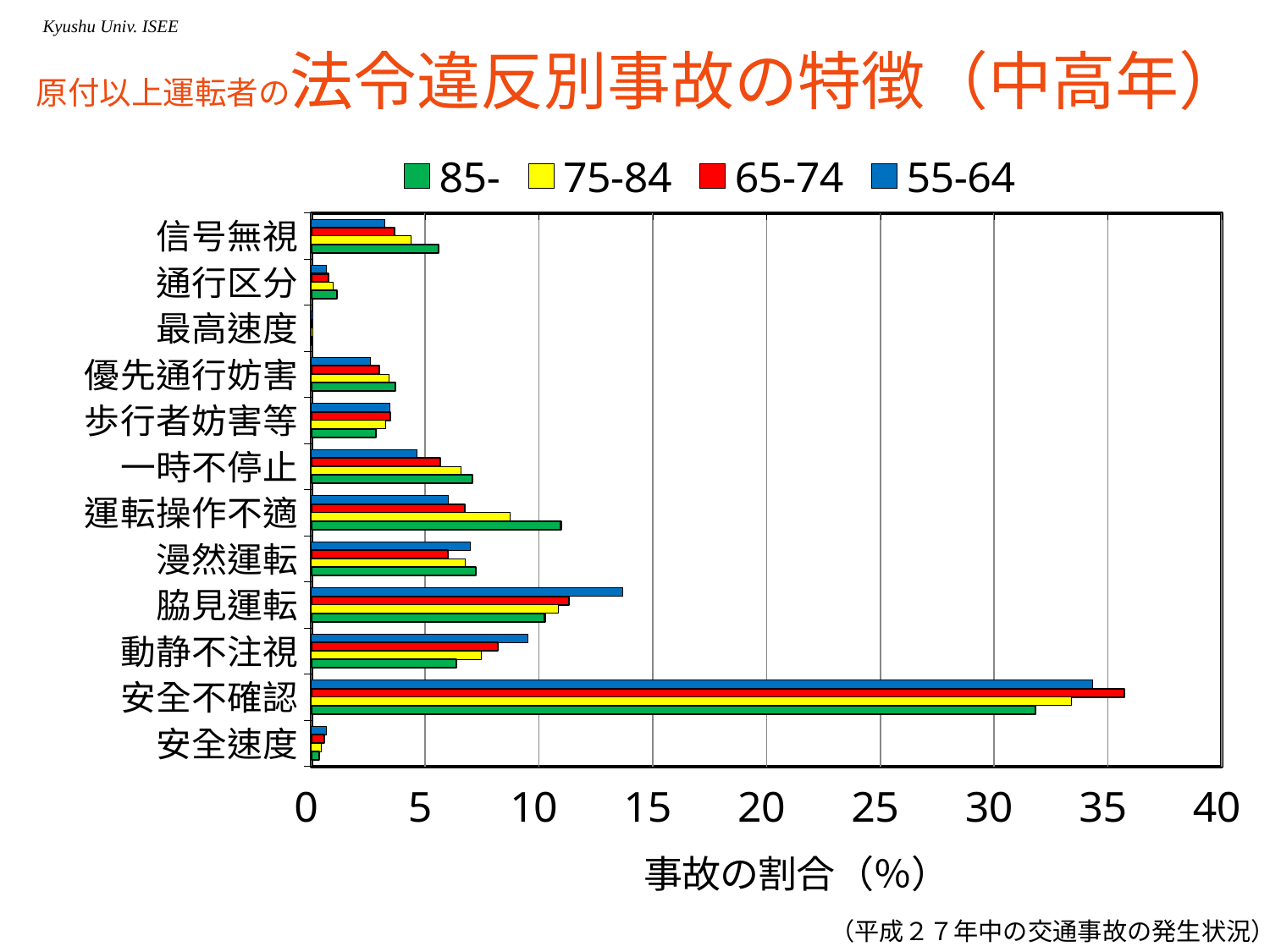
For 運転操作不適, which series has the larger value: 85- or 55-64? 85- What kind of chart is shown on the slide? bar chart Is the value for 最高速度 in the 65-74 series greater or less than 5? less Is the value for 運転操作不適 in the 85- series greater or less than 10? greater How many violation categories are listed on the vertical axis of the chart? 12 Which violation category has the highest accident share for every age group? 安全不確認 How many series does the legend list? 4 Is the value for 脇見運転 in the 55-64 series greater or less than 10? greater For 脇見運転, which series has the larger value: 55-64 or 85-? 55-64 What is the label of the horizontal axis of the chart? 事故の割合（%） Which violation category has the lowest accident share across the age groups? 最高速度